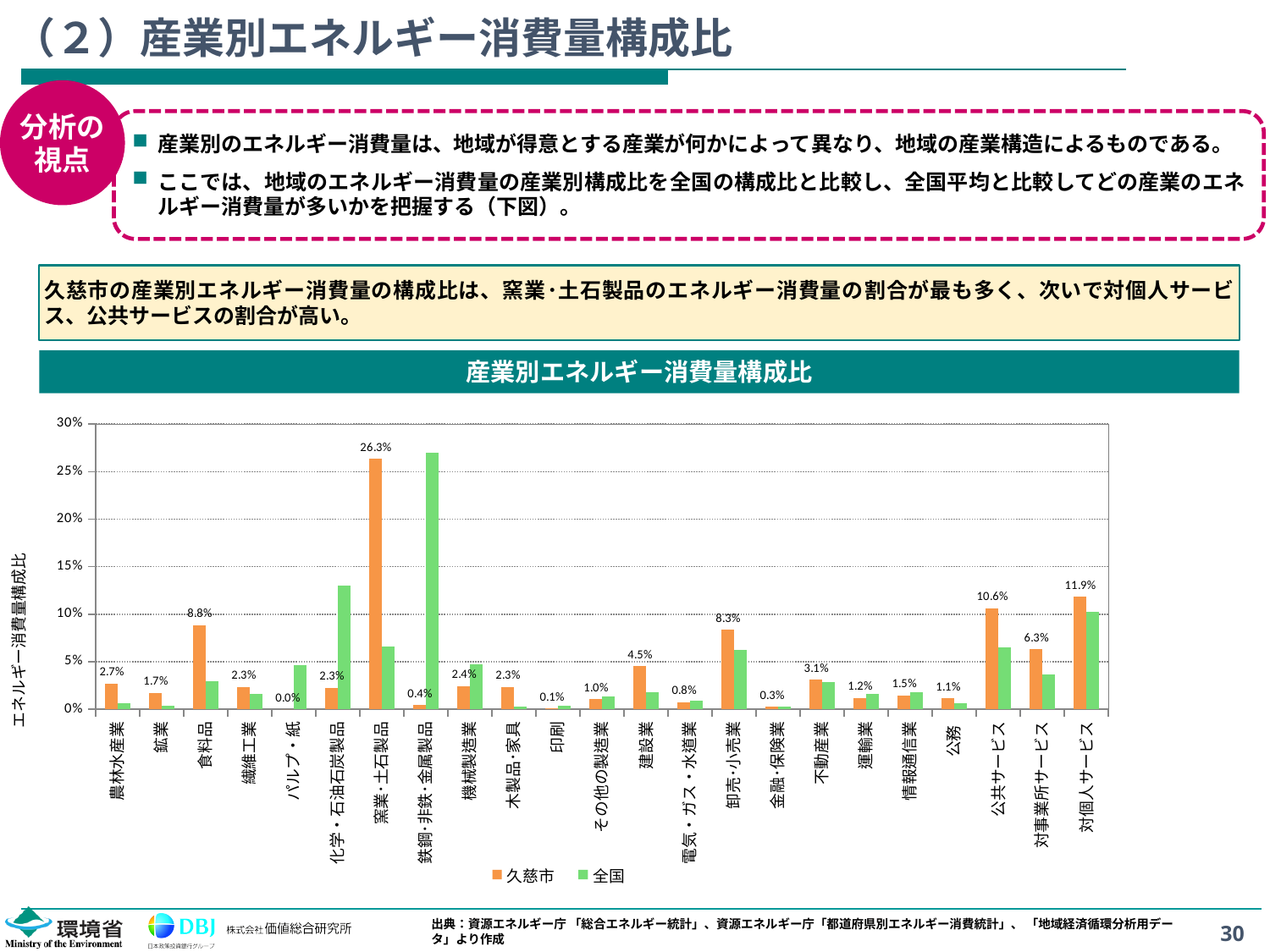
Is the 全国 value for 化学・石油石炭製品 greater or less than 10%? greater Which category has the highest 久慈市 value? 窯業・土石製品 What is the 久慈市 value for 公共サービス? 10.6% What kind of chart is shown on the slide? Bar chart Which has the larger 久慈市 value, 卸売・小売業 or 建設業? 卸売・小売業 What is the 久慈市 value for 食料品? 8.8% What is the 久慈市 value for 窯業・土石製品? 26.3% How many series does the legend list? 2 Which category has the lowest 久慈市 value? パルプ・紙 How many industry categories are shown on the x axis? 23 Is the 全国 value for 鉄鋼・非鉄・金属製品 greater or less than 25%? greater What is the difference between the 久慈市 values for 対個人サービス and 対事業所サービス? 5.6%